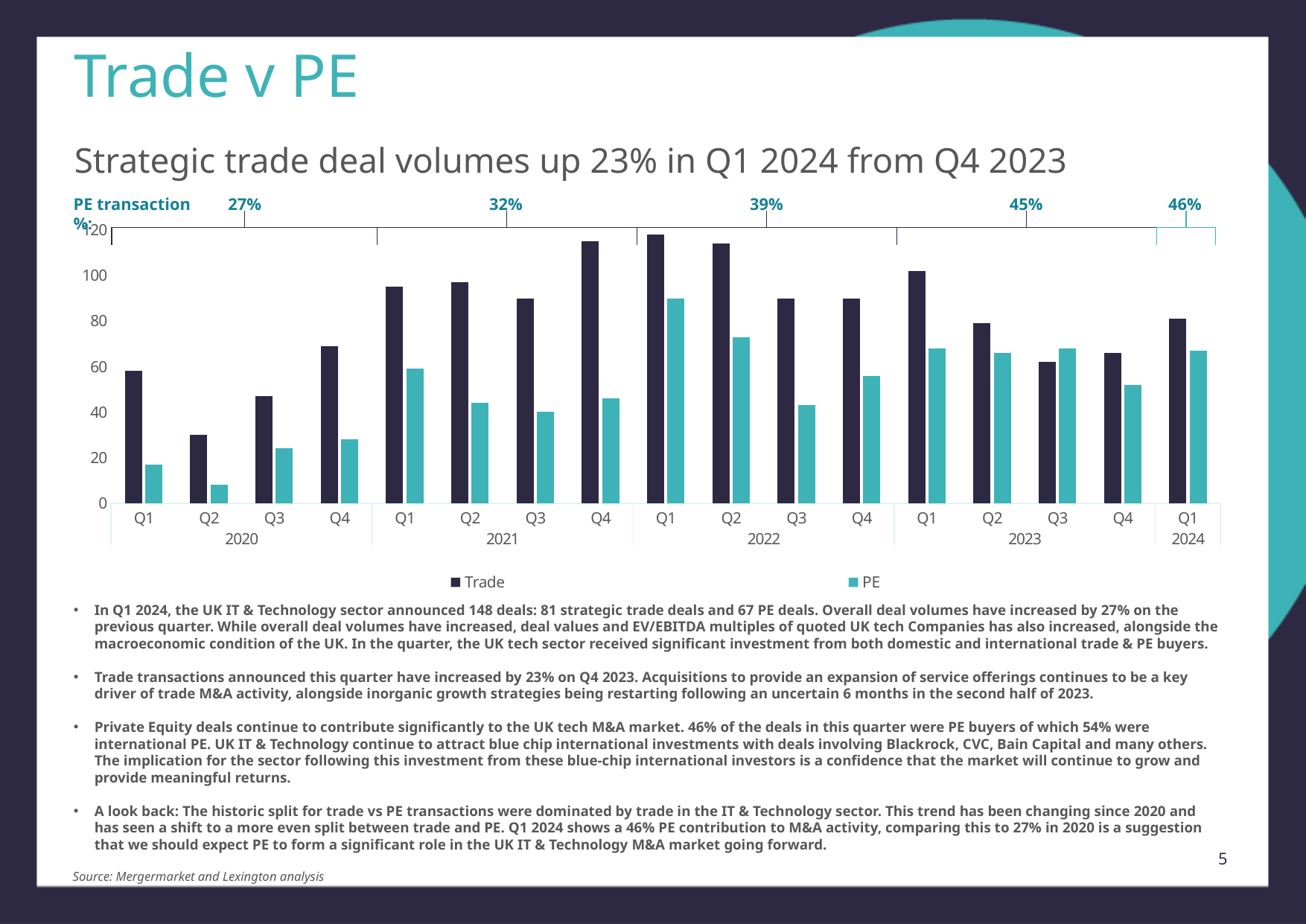
Which quarter has the lowest Trade value in the chart? Q2 2020 What kind of chart is shown on the slide? bar chart How many series does the chart legend list? 2 Is the Trade value for Q1 2024 greater or less than 60? greater In Q4 2023, which is larger, the Trade value or the PE value? Trade Is the Trade value for Q4 2021 greater or less than 100? greater Which quarter has the highest PE value in the chart? Q1 2022 Which quarter has the lowest PE value in the chart? Q2 2020 Is the PE value for Q2 2020 greater or less than 20? less What PE transaction % is shown above the chart for 2022? 39% In Q1 2020, which is larger, the Trade value or the PE value? Trade How many quarters are plotted along the x axis of the chart? 17